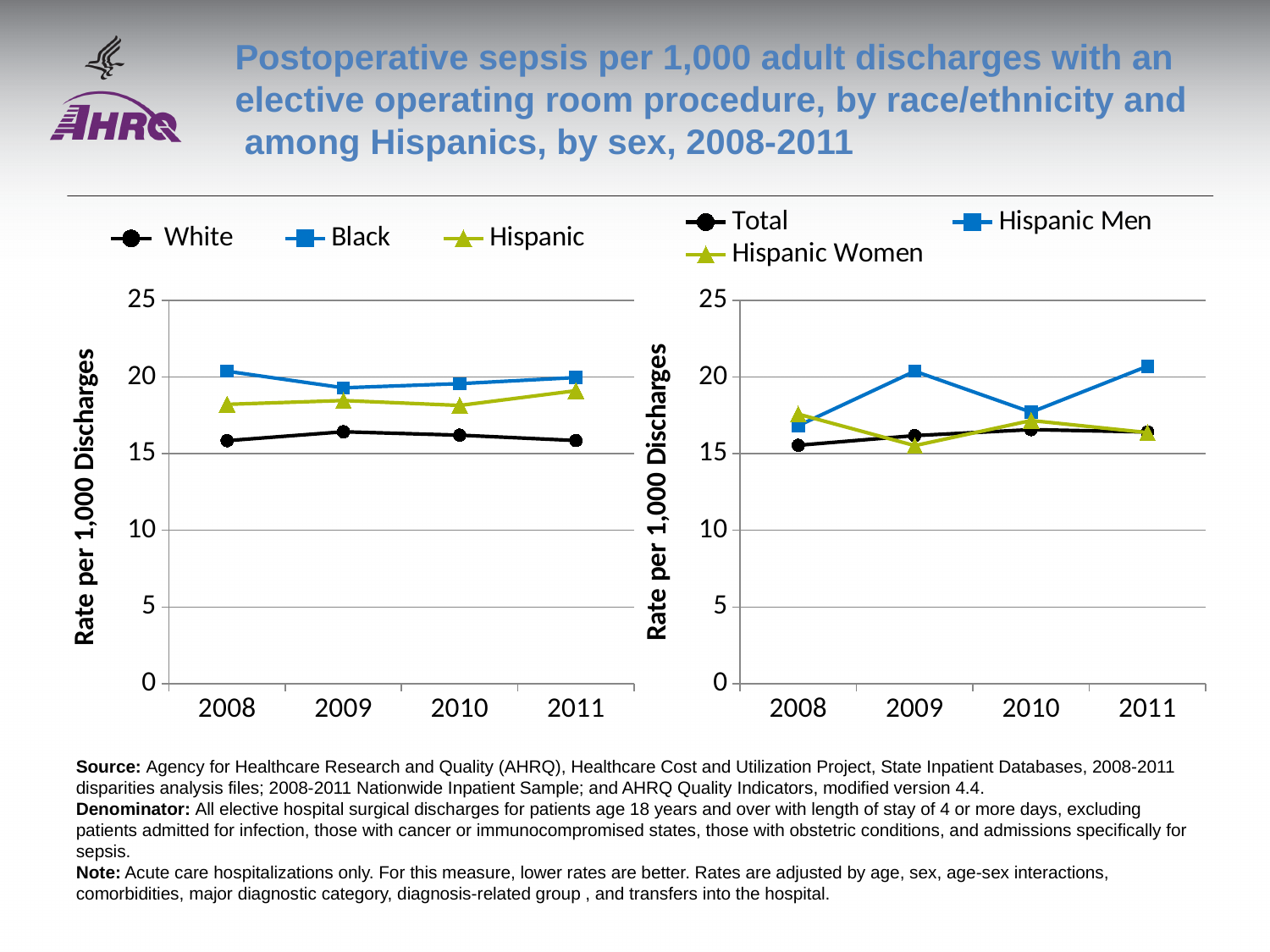
How many years are shown on the x axis of the left chart? 4 In the right chart, is the value for Hispanic Men in 2009 greater or less than 15? greater In the left chart, is the value for White in 2008 greater or less than 20? less In the left chart, which is larger in 2010, the value for Black or the value for White? Black What is the y-axis label on the left chart? Rate per 1,000 Discharges In the left chart, which race/ethnicity group has the highest rate in 2008? Black In the right chart, which series has the highest rate in 2011? Hispanic Men In the left chart, which race/ethnicity group has the lowest rate in 2011? White In the right chart, which is larger in 2009, the value for Hispanic Men or the value for Hispanic Women? Hispanic Men How many series does the legend of the left chart list? 3 How many series does the legend of the right chart list? 3 What kind of chart is the left chart (White, Black, Hispanic)? line chart